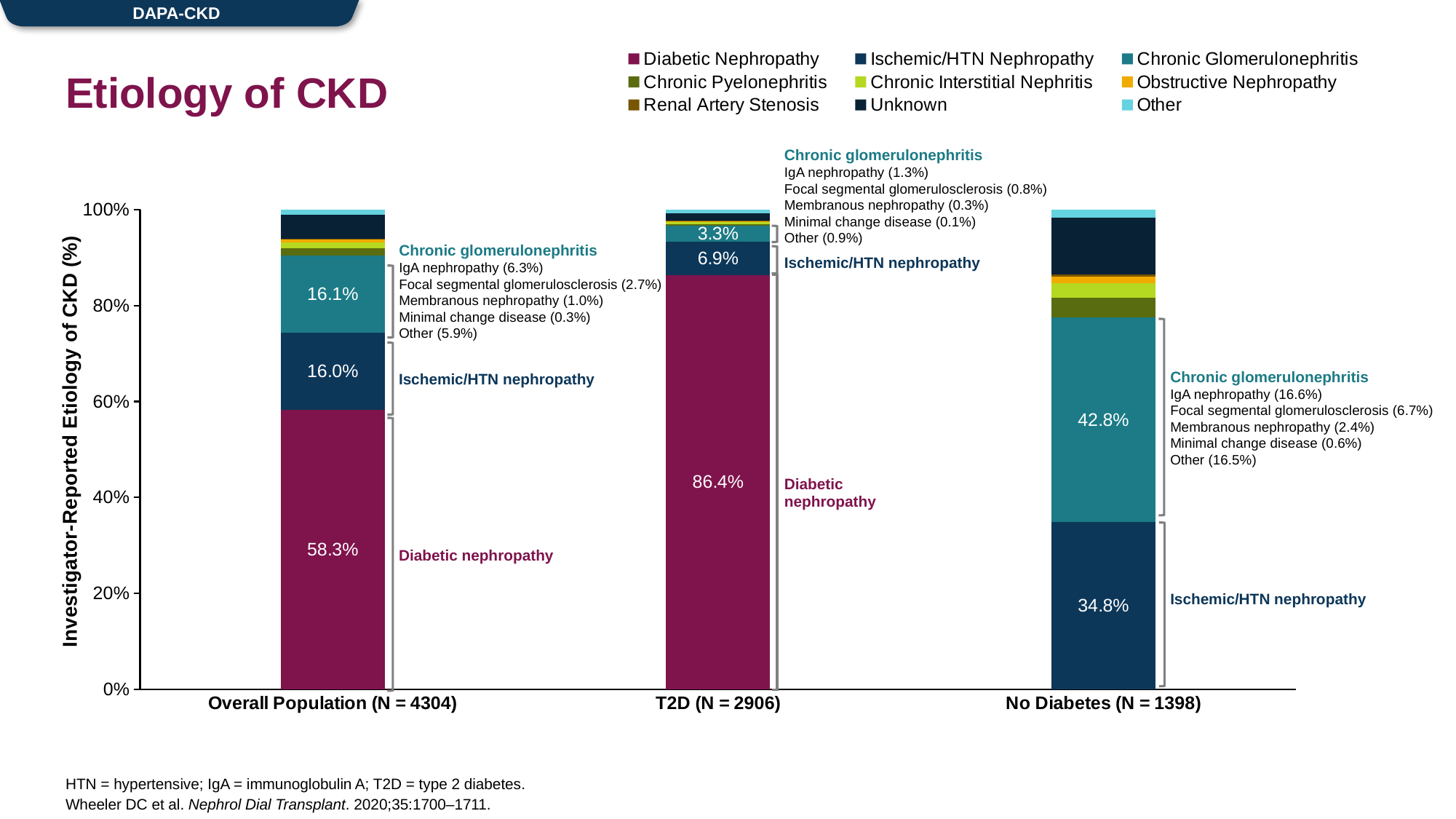
What is the Diabetic Nephropathy value for the T2D (N = 2906) group? 86.4% In the Overall Population bar, which is larger: Chronic Glomerulonephritis or Ischemic/HTN Nephropathy? Chronic Glomerulonephritis What is the difference between the Ischemic/HTN Nephropathy percentages for No Diabetes and the Overall Population? 18.8% What is the Ischemic/HTN Nephropathy value for the T2D (N = 2906) group? 6.9% How many groups (bars) are shown on the x axis? 3 Which group has the highest Diabetic Nephropathy percentage? T2D (N = 2906) What is the Ischemic/HTN Nephropathy value for the No Diabetes (N = 1398) group? 34.8% Which group has the lowest Chronic Glomerulonephritis percentage? T2D (N = 2906) How many etiology series does the legend list? 9 What is the difference between the Diabetic Nephropathy percentages for T2D and the Overall Population? 28.1% What is the Chronic Glomerulonephritis value for the No Diabetes (N = 1398) group? 42.8% What percentage of the Overall Population (N = 4304) bar is Diabetic Nephropathy? 58.3%